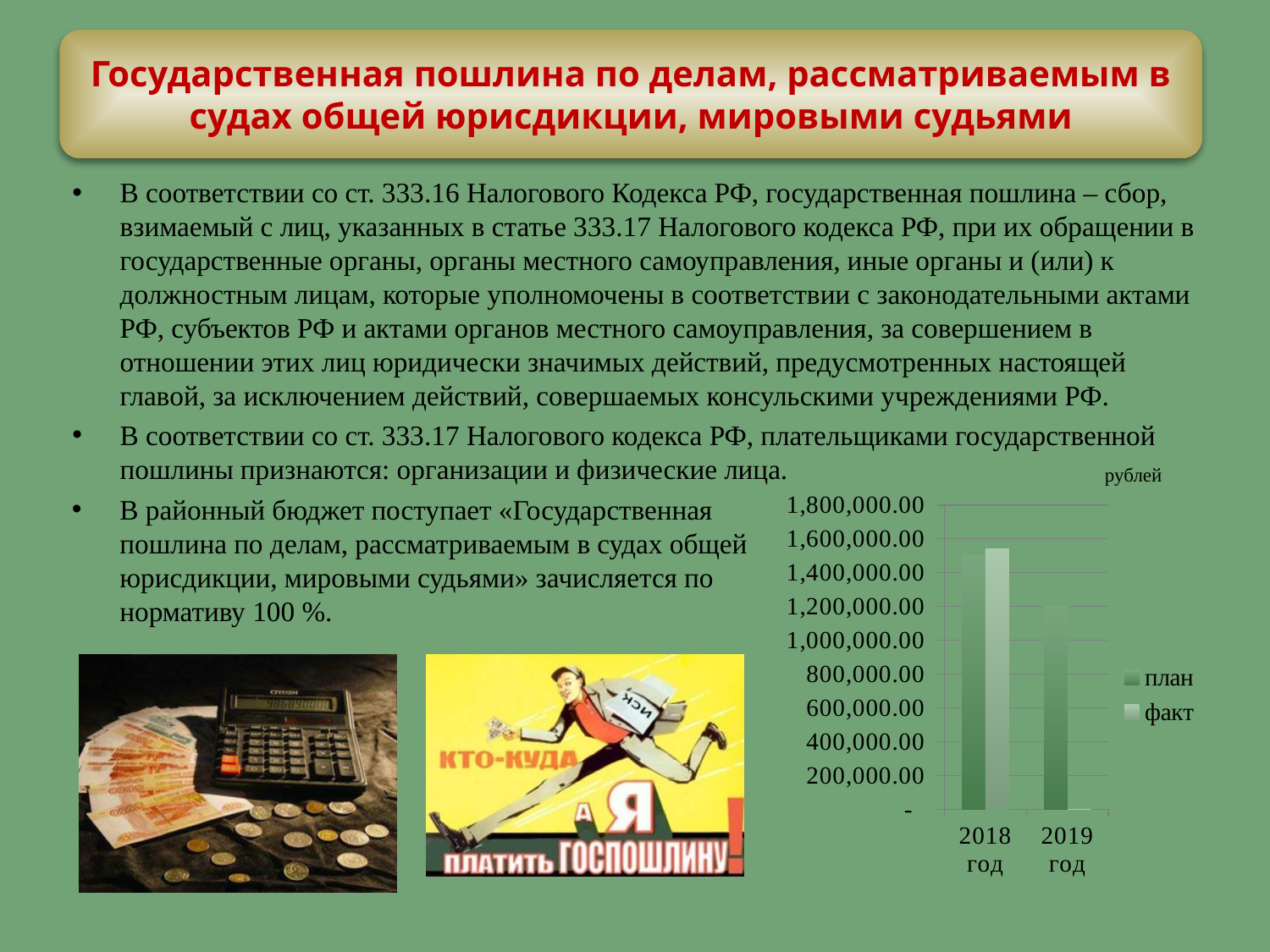
What are the two series named in the chart legend? план, факт Is the план value for 2019 год greater or less than 1,400,000.00? less What kind of chart is shown on the slide? bar chart For 2019 год, which is larger, план or факт? план How many year categories are shown on the x axis of the chart? 2 How many series does the chart legend list? 2 Is the план value for 2018 год greater or less than 1,400,000.00? greater Is the факт value for 2018 год greater or less than 1,400,000.00? greater Do the факт values rise or fall from 2018 год to 2019 год? fall Which year has the larger план value, 2018 год or 2019 год? 2018 год What unit label is printed above the chart's vertical axis? рублей